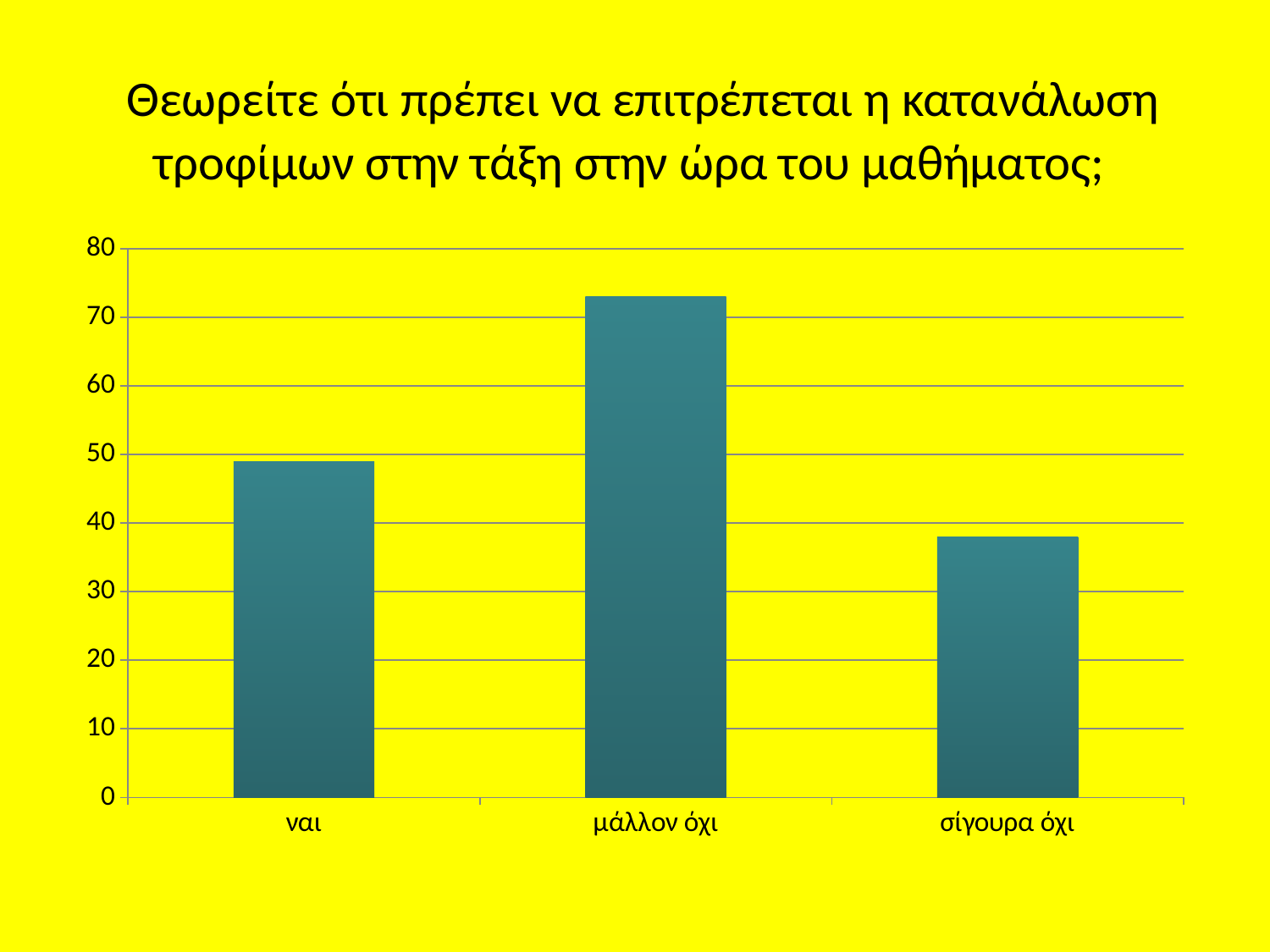
How many categories are shown on the x axis of the chart? 3 Is the value for ναι greater or less than 60? less Which category has the lowest bar? σίγουρα όχι Is the value for μάλλον όχι greater or less than 60? greater Which is larger, the value for ναι or the value for σίγουρα όχι? ναι Which is larger, the value for ναι or the value for μάλλον όχι? μάλλον όχι What kind of chart is shown on the slide? bar chart Which category has the highest bar? μάλλον όχι What is the label of the first category on the x axis? ναι Is the value for ναι greater or less than 40? greater What is the highest value shown on the vertical axis of the chart? 80